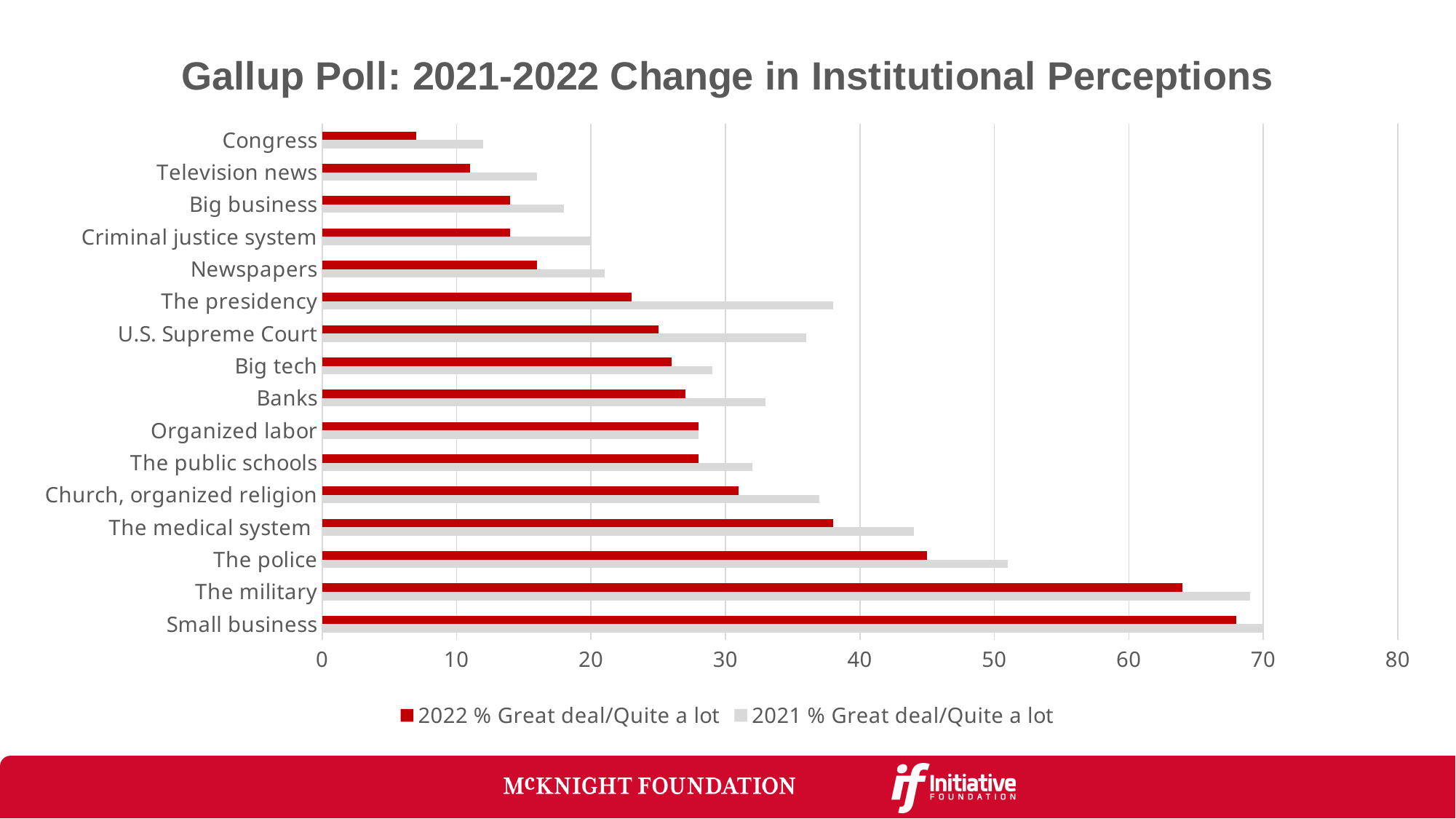
How many institutions are listed on the chart? 16 Is the 2021 value for The presidency greater or less than 30? greater Which institution has the highest 2021 % Great deal/Quite a lot value? Small business How many series does the legend list? 2 What is the title of the chart? Gallup Poll: 2021-2022 Change in Institutional Perceptions Is the 2022 value for Congress greater or less than 10? less Which colour represents the 2022 % Great deal/Quite a lot series? red Which institution has the lowest 2022 % Great deal/Quite a lot value? Congress Which institution has the highest 2022 % Great deal/Quite a lot value? Small business Is the 2022 value for The military greater or less than 60? greater Which is larger, the 2022 value for The police or the 2022 value for The medical system? The police What kind of chart is shown on the slide? bar chart